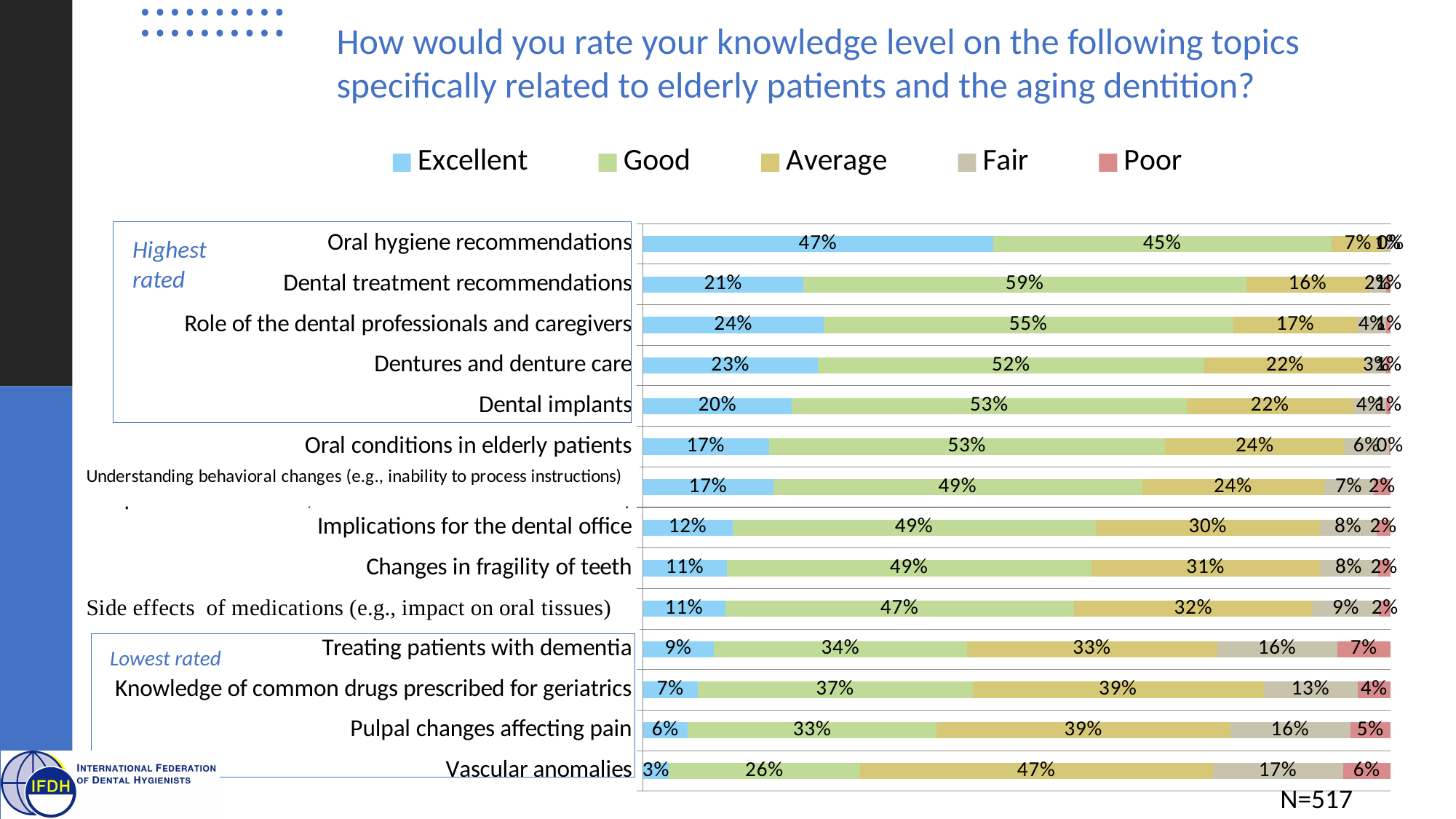
How many topics (categories) are plotted in the chart? 14 What is the Poor value for Treating patients with dementia? 7% Which has a larger Average value: Treating patients with dementia or Pulpal changes affecting pain? Pulpal changes affecting pain Which topic has the lowest Excellent percentage? Vascular anomalies What percentage rated their knowledge of Oral hygiene recommendations as Excellent? 47% How many series does the legend list? 5 Which topic has the highest Excellent percentage? Oral hygiene recommendations What is the Average value for Knowledge of common drugs prescribed for geriatrics? 39% What sample size (N) is shown on the slide? N=517 What is the difference between the Good value for Oral hygiene recommendations and the Good value for Vascular anomalies? 19 percentage points What is the Good value for Dental treatment recommendations? 59% What kind of chart is shown on the slide? Stacked bar chart